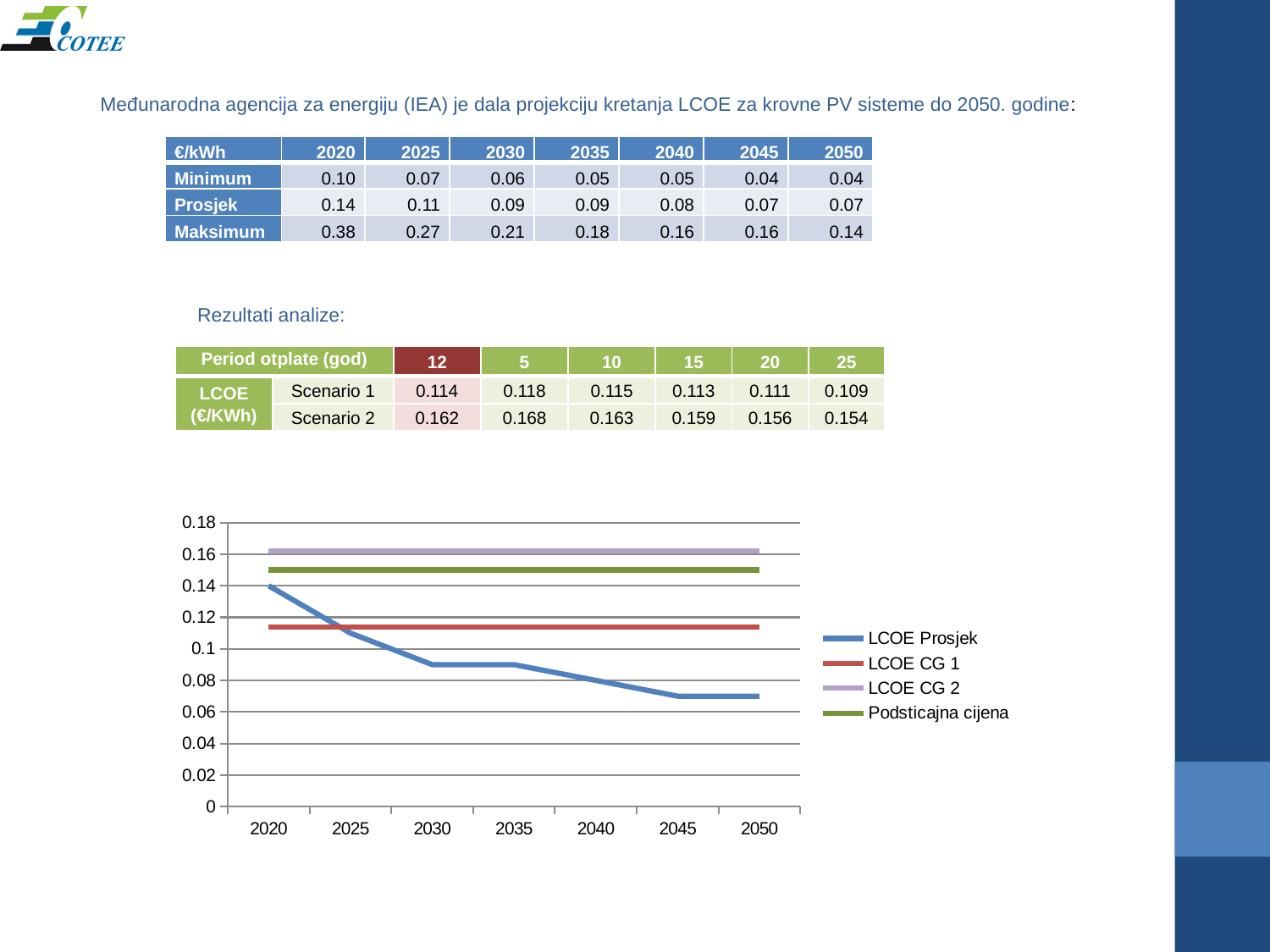
What kind of chart is shown on the slide? line chart Does the LCOE Prosjek line rise or fall from 2020 to 2050? fall Is the value of LCOE CG 1 greater or less than 0.12? less Is the value of Podsticajna cijena greater or less than 0.14? greater Which series has the highest values on the chart? LCOE CG 2 Which is higher on the chart, LCOE CG 1 or Podsticajna cijena? Podsticajna cijena Is the value of LCOE Prosjek in 2050 greater or less than 0.08? less What is the value of LCOE Prosjek in 2020 on the chart? 0.14 Which series has the lowest value in 2050 on the chart? LCOE Prosjek What is the last entry in the chart legend? Podsticajna cijena How many series does the chart legend list? 4 How many years are marked along the x axis of the chart? 7